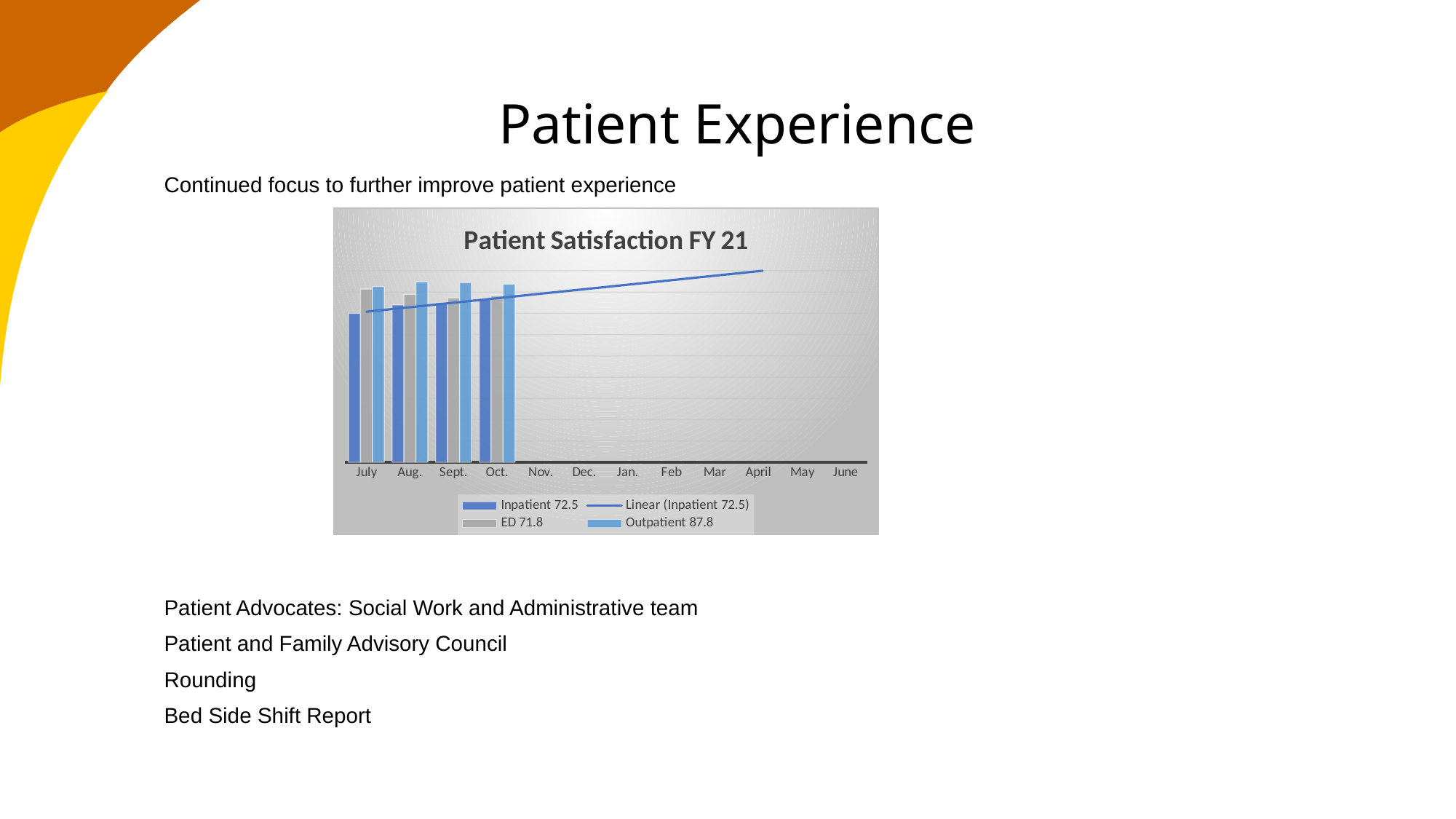
Which legend entry is shown as a line rather than bars? Linear (Inpatient 72.5) Which series has the tallest bar in October? Outpatient 87.8 For how many months does the chart show plotted bars? 4 What is the title of the chart? Patient Satisfaction FY 21 Does the linear trend line for Inpatient slope upward or downward across the chart? Upward Do the Inpatient bars rise or fall from July to October? Rise What type of chart is shown on the slide? Bar chart In which month is the Inpatient bar the lowest? July How many month categories are shown on the x axis of the chart? 12 In July, which is larger: the Inpatient bar or the Outpatient bar? Outpatient How many entries does the chart legend list? 4 In July, which is larger: the Inpatient bar or the ED bar? ED